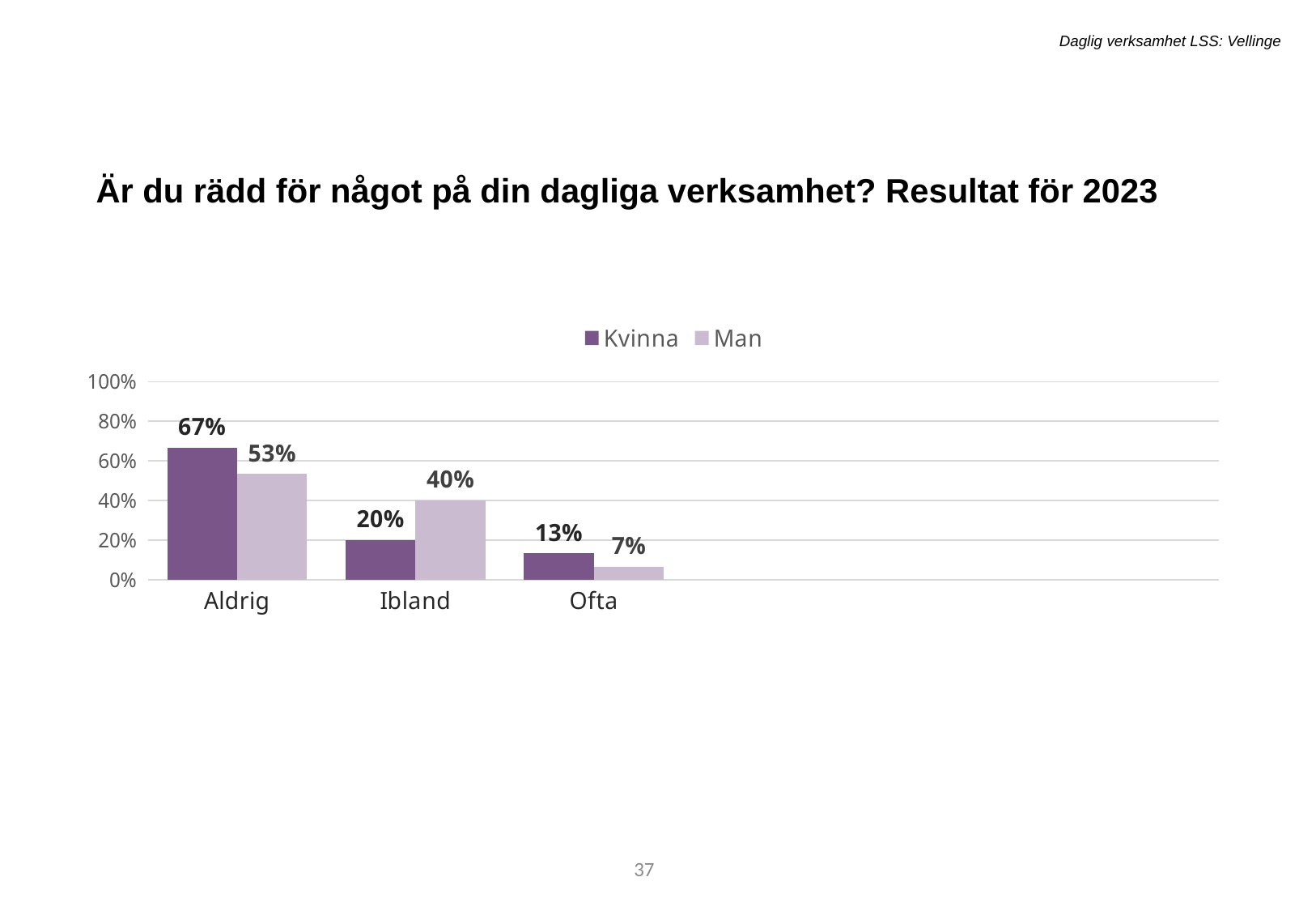
What is the value for Man in the Ibland category? 40% What is the value for Man in the Ofta category? 7% What is the difference between the Kvinna and Man values in the Aldrig category? 14% In the Ibland category, which series has the larger value, Kvinna or Man? Man What kind of chart is shown on the slide? Bar chart What is the value for Kvinna in the Aldrig category? 67% How many categories are shown on the x axis? 3 Which category has the lowest value for the Man series? Ofta How many series does the legend list? 2 What is the difference between the Man and Kvinna values in the Ibland category? 20% Which category has the highest value for the Kvinna series? Aldrig What is the value for Kvinna in the Ofta category? 13%